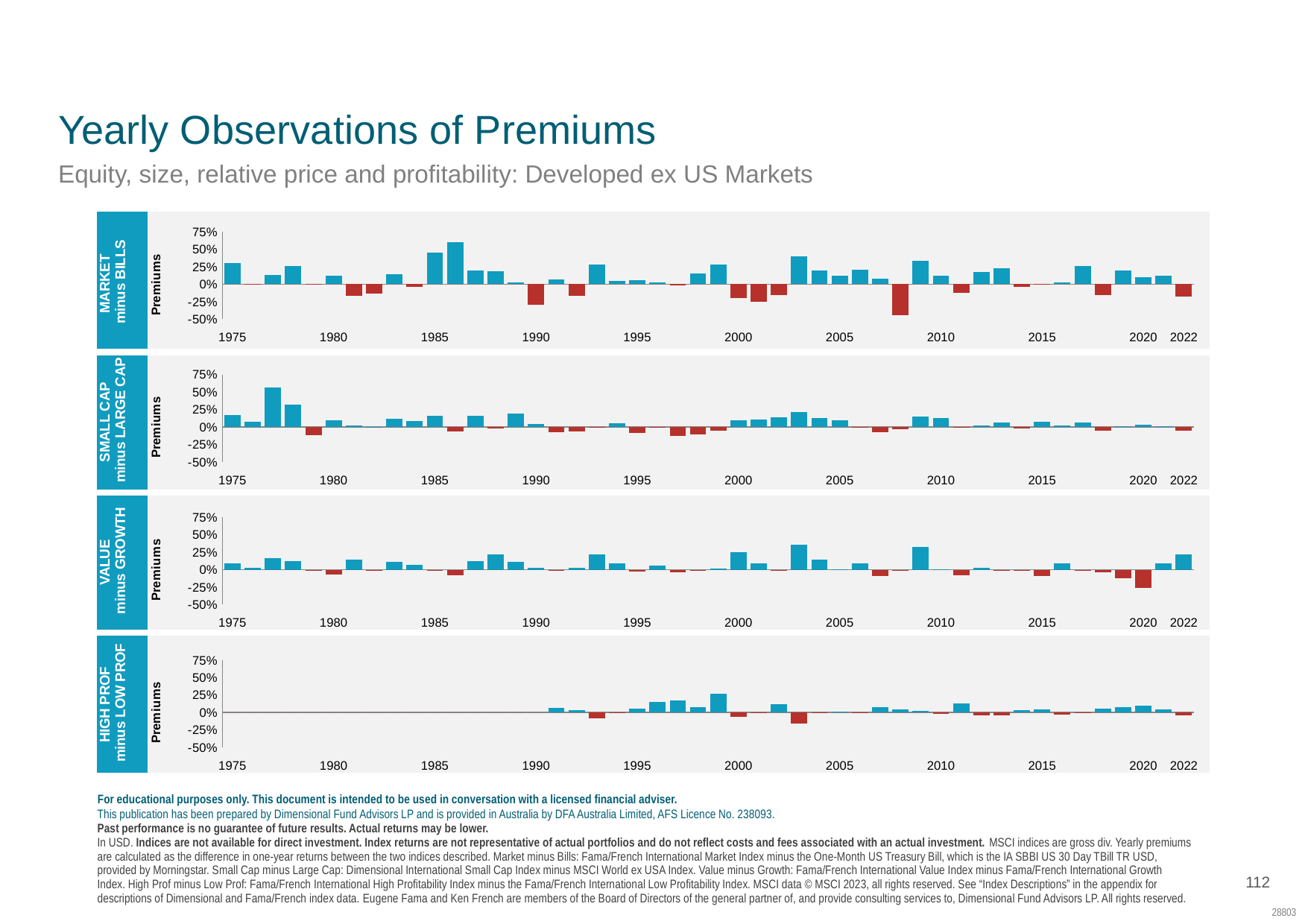
In the MARKET minus BILLS chart, which year has the lowest value? 2008 In the HIGH PROF minus LOW PROF chart, is the value for 2003 greater or less than 0%? less In the VALUE minus GROWTH chart, is the value for 2003 greater or less than 25%? greater What colour are the bars with negative values in the charts? Red In the SMALL CAP minus LARGE CAP chart, which year has the highest value? 1977 What is the title of the slide containing the charts? Yearly Observations of Premiums In the VALUE minus GROWTH chart, is the value for 2020 greater or less than 0%? less What type of chart is used in each of the four panels on the slide? Bar chart How many separate charts (panels) are shown on the slide? 4